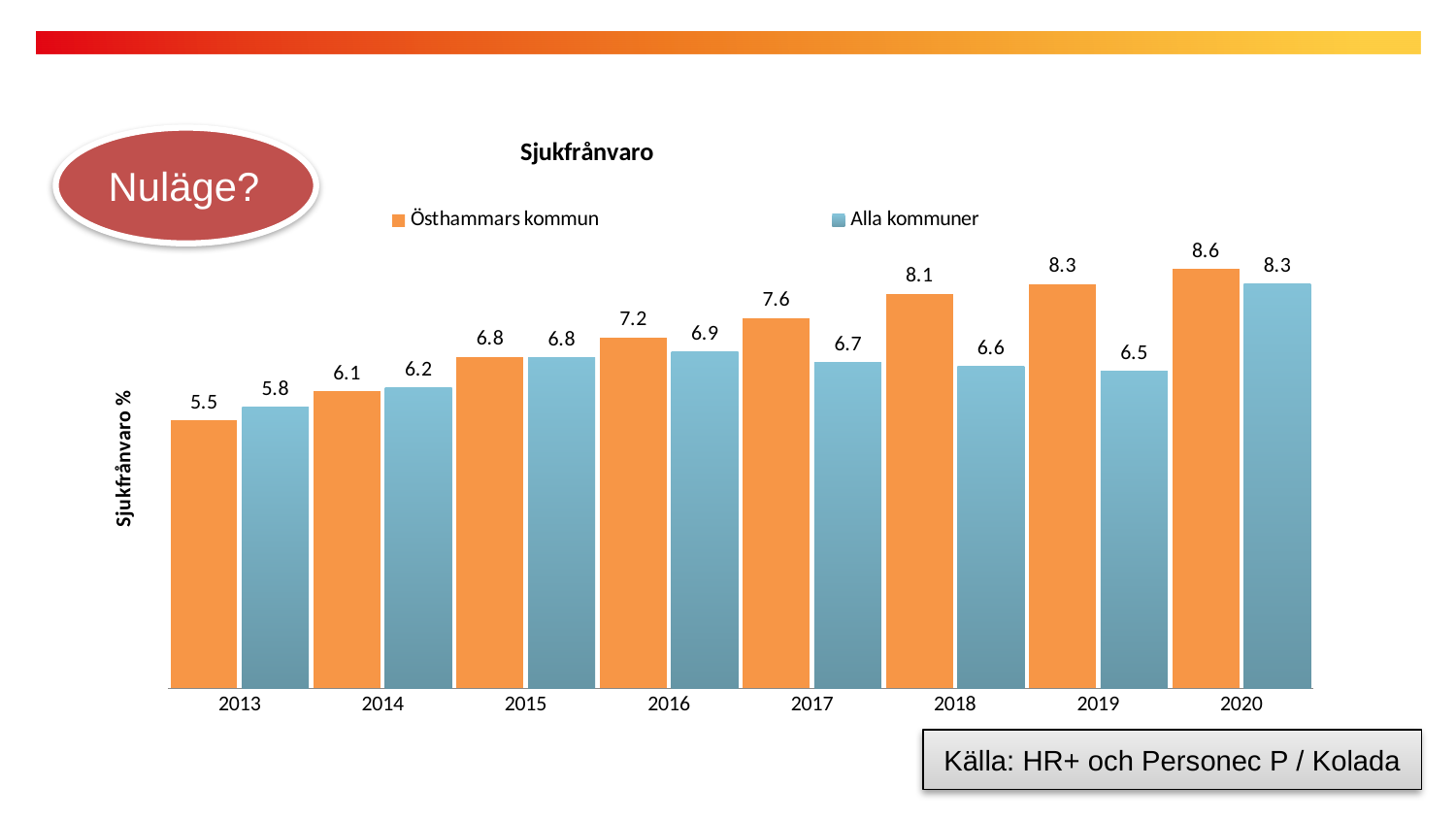
Do the values for Östhammars kommun rise or fall from 2013 to 2020? Rise How many years are shown on the x axis? 8 In which year is the value for Östhammars kommun lowest? 2013 What kind of chart is shown? Bar chart Which series has the larger value in 2014, Östhammars kommun or Alla kommuner? Alla kommuner What is the title of the chart? Sjukfrånvaro What is the value for Alla kommuner in 2019? 6.5 What is the value for Östhammars kommun in 2013? 5.5 In which year is the value for Östhammars kommun highest? 2020 What is the value for Östhammars kommun in 2017? 7.6 What is the difference between Östhammars kommun and Alla kommuner in 2019? 1.8 How many series does the legend list? 2